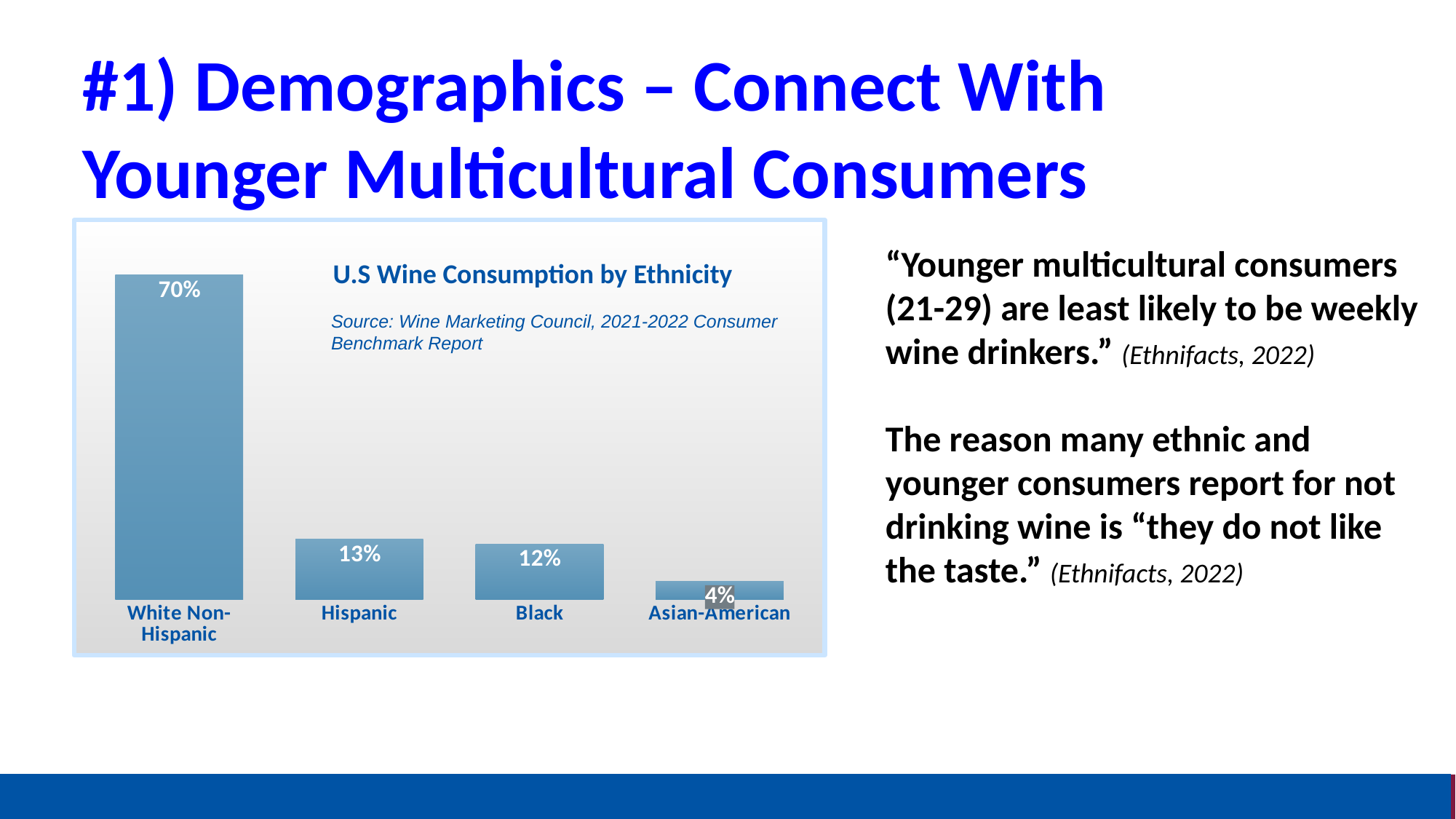
What is the value for White Non-Hispanic in the U.S Wine Consumption by Ethnicity chart? 70% What kind of chart is the U.S Wine Consumption by Ethnicity chart? Bar chart What is the value for Asian-American in the U.S Wine Consumption by Ethnicity chart? 4% Which is larger in the U.S Wine Consumption by Ethnicity chart, the value for Hispanic or the value for Asian-American? Hispanic What source is cited for the U.S Wine Consumption by Ethnicity chart? Wine Marketing Council, 2021-2022 Consumer Benchmark Report What is the difference between the White Non-Hispanic and Hispanic values in the U.S Wine Consumption by Ethnicity chart? 57% Which category has the lowest value in the U.S Wine Consumption by Ethnicity chart? Asian-American What is the difference between the Black and Asian-American values in the U.S Wine Consumption by Ethnicity chart? 8% Which category has the highest value in the U.S Wine Consumption by Ethnicity chart? White Non-Hispanic How many categories are shown in the U.S Wine Consumption by Ethnicity chart? 4 What is the value for Black in the U.S Wine Consumption by Ethnicity chart? 12% What is the value for Hispanic in the U.S Wine Consumption by Ethnicity chart? 13%